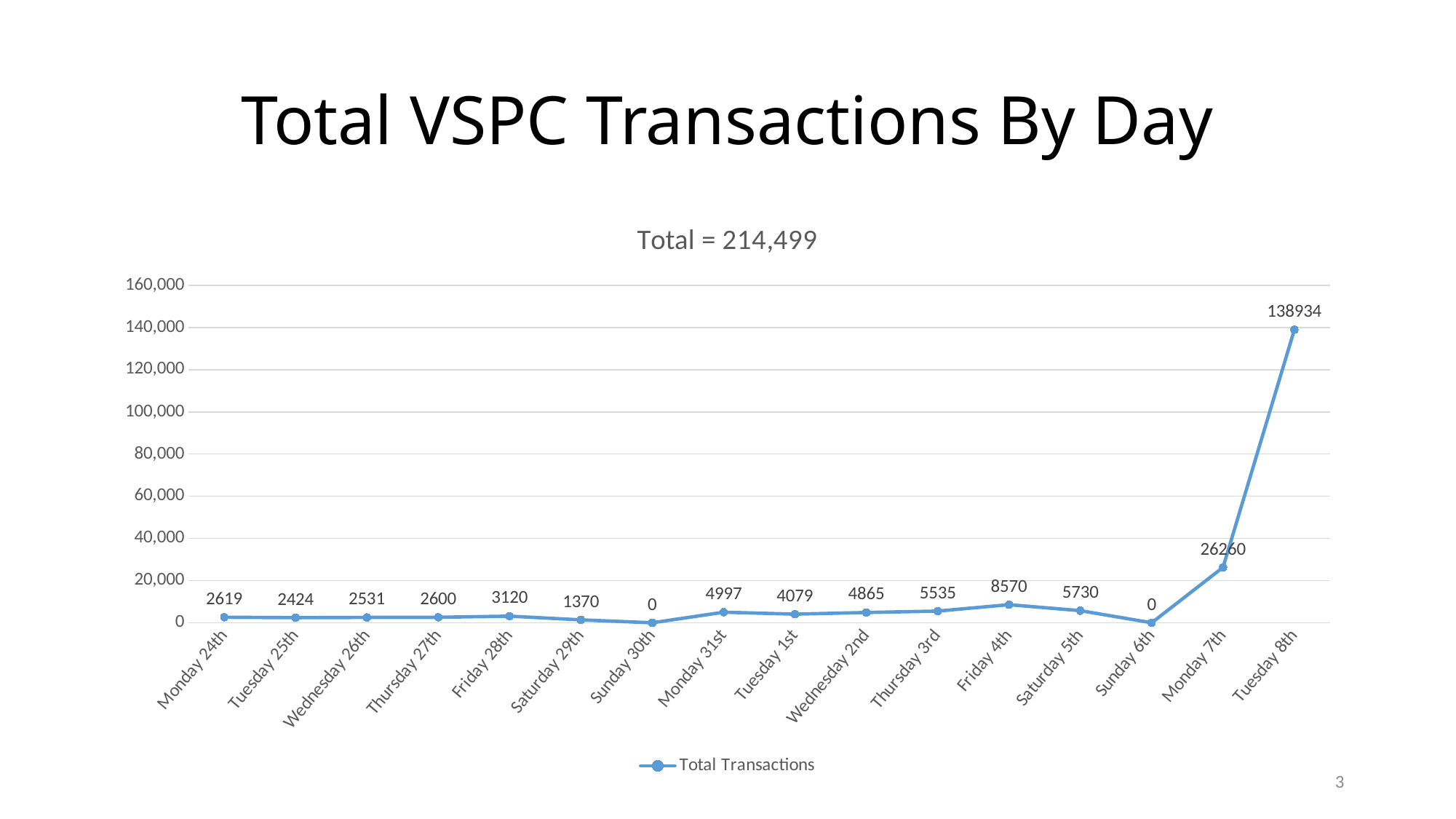
How many days are plotted on the x axis? 16 What is the value for Friday 4th? 8570 Is the value for Tuesday 8th greater or less than 120,000? greater Which day has the highest number of total transactions? Tuesday 8th How many series does the legend list? 1 What is the difference between the values for Tuesday 8th and Monday 7th? 112674 What is the value for Saturday 29th? 1370 What is the value for Monday 7th? 26260 What kind of chart is shown? line chart What is the value for Tuesday 8th? 138934 Which is larger, the value for Thursday 3rd or the value for Wednesday 2nd? Thursday 3rd What is the chart's subtitle shown above the plot area? Total = 214,499